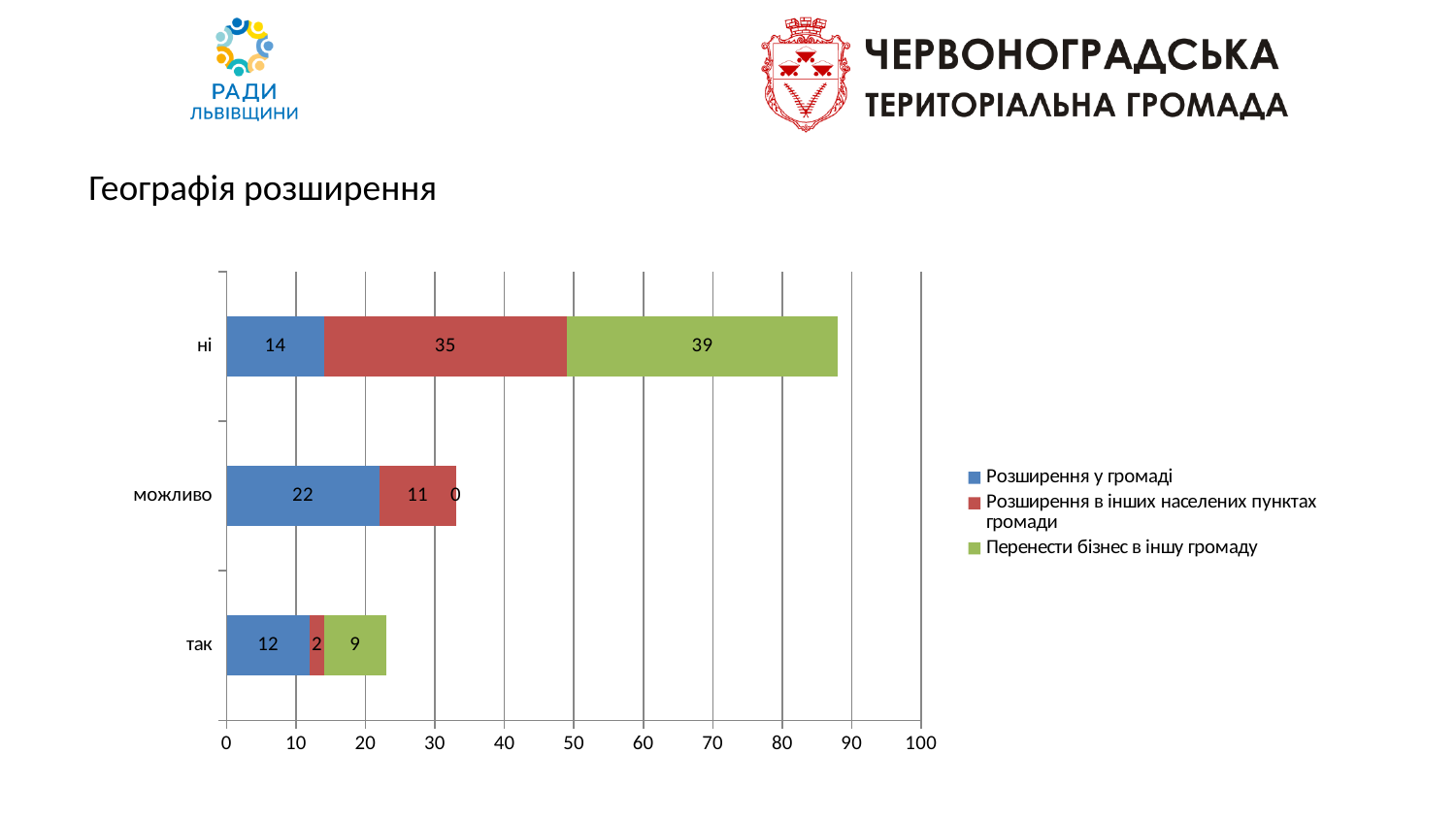
What is the value of "Розширення у громаді" for the category "ні"? 14 What is the value of "Розширення в інших населених пунктах громади" for the category "можливо"? 11 What is the total of the stacked bar for "ні"? 88 What is the value of "Перенести бізнес в іншу громаду" for the category "так"? 9 What is the value of "Перенести бізнес в іншу громаду" for the category "ні"? 39 Which category has the highest value for "Розширення у громаді"? можливо Which category has the lowest value for "Розширення в інших населених пунктах громади"? так How many categories are shown on the vertical axis? 3 What is the difference between the "Перенести бізнес в іншу громаду" values for "ні" and "так"? 30 What kind of chart is shown on the slide? stacked bar chart How many series does the legend list? 3 Which is larger: the "Розширення у громаді" value for "ні" or for "так"? ні